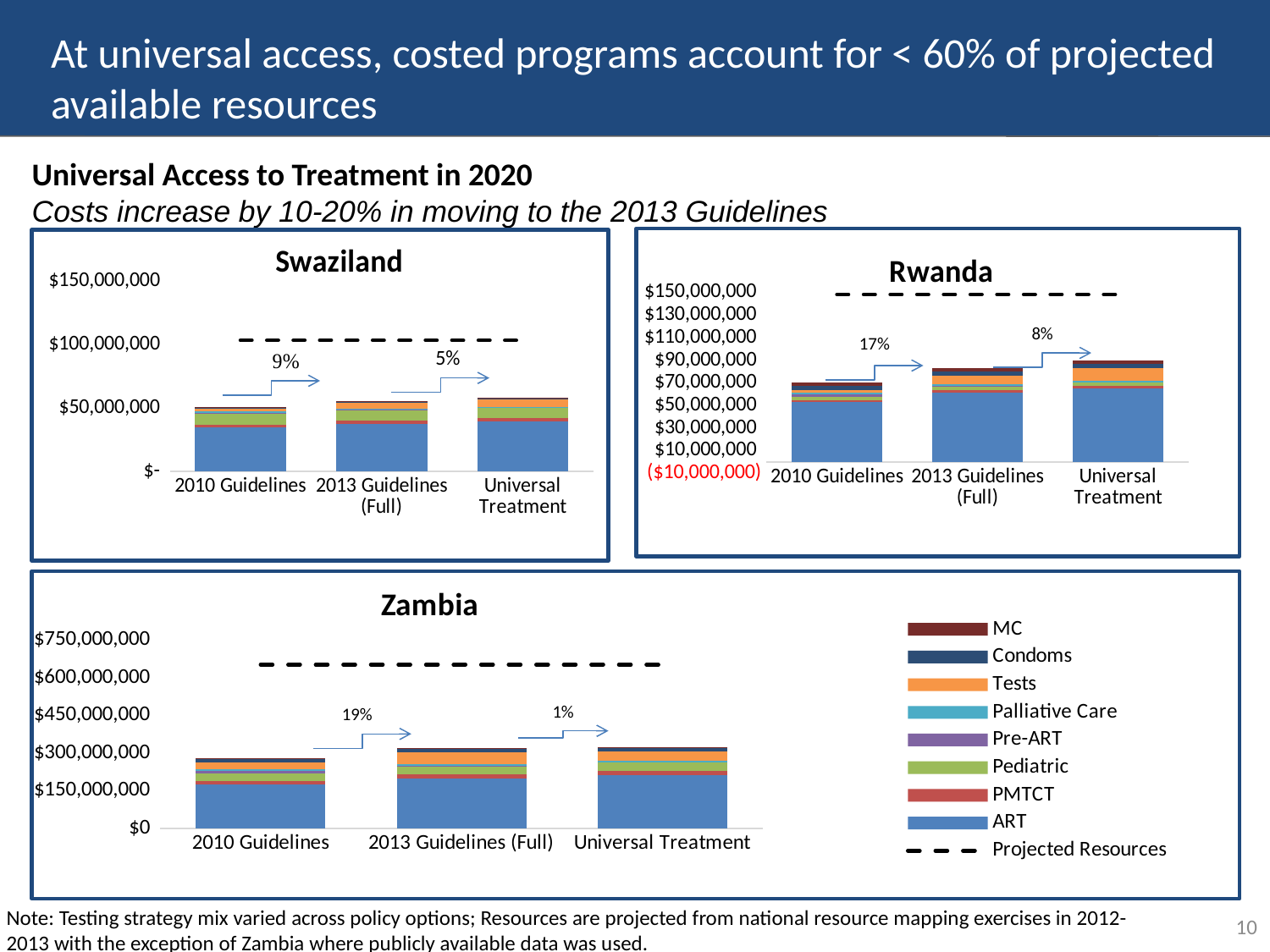
How many policy options (categories) are shown on the x axis of the Swaziland chart? 3 What type of chart is the Zambia chart? Stacked bar chart In the Rwanda chart, which policy option has the lowest total cost bar? 2010 Guidelines In the Rwanda chart, what percentage increase is labelled between 2010 Guidelines and 2013 Guidelines (Full)? 17% In the Swaziland chart, is the total for Universal Treatment greater or less than $50,000,000? greater In the Zambia chart, what percentage increase is labelled between 2013 Guidelines (Full) and Universal Treatment? 1% In the Rwanda chart, which policy option has the highest total cost bar? Universal Treatment In the Swaziland chart, what percentage increase is labelled between 2013 Guidelines (Full) and Universal Treatment? 5% In the Swaziland chart, what percentage increase is labelled between 2010 Guidelines and 2013 Guidelines (Full)? 9% In the Zambia chart, is the Projected Resources line greater or less than $600,000,000? greater How many entries does the legend on the slide list? 9